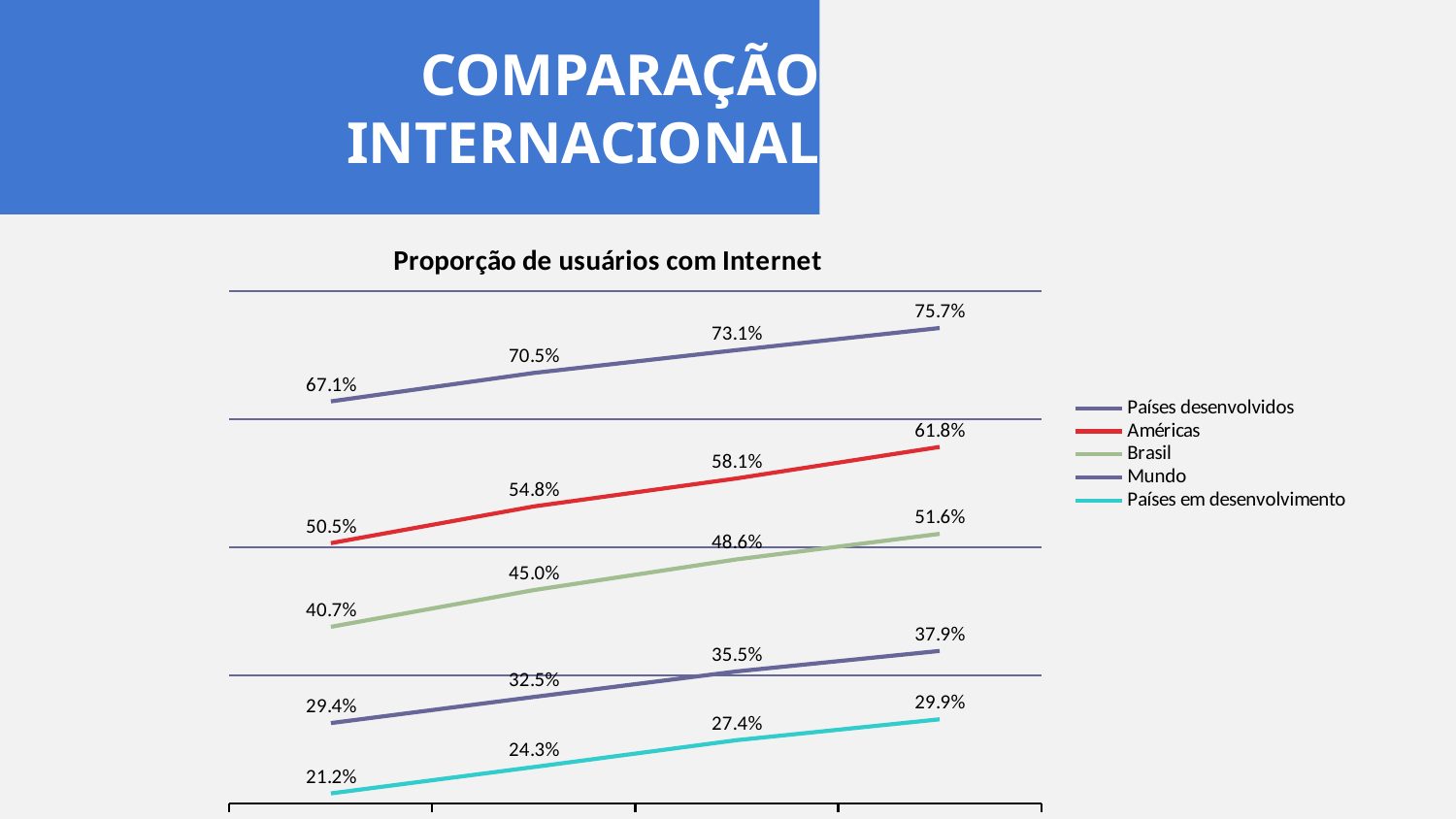
Is the last value for Brasil larger or smaller than the last value for Mundo? larger Which series has the lowest values throughout the chart? Países em desenvolvimento What is the last (rightmost) value for Países em desenvolvimento? 29.9% Do the values for Mundo rise or fall from left to right? rise What is the difference between the last and first values of the Américas line? 11.3% What is the last (rightmost) value for Países desenvolvidos? 75.7% What is the title of the chart? Proporção de usuários com Internet What kind of chart is shown on the slide? line chart What is the first (leftmost) value for Brasil? 40.7% How many data points does each line have? 4 How many series does the legend list? 5 Which series has the highest values throughout the chart? Países desenvolvidos